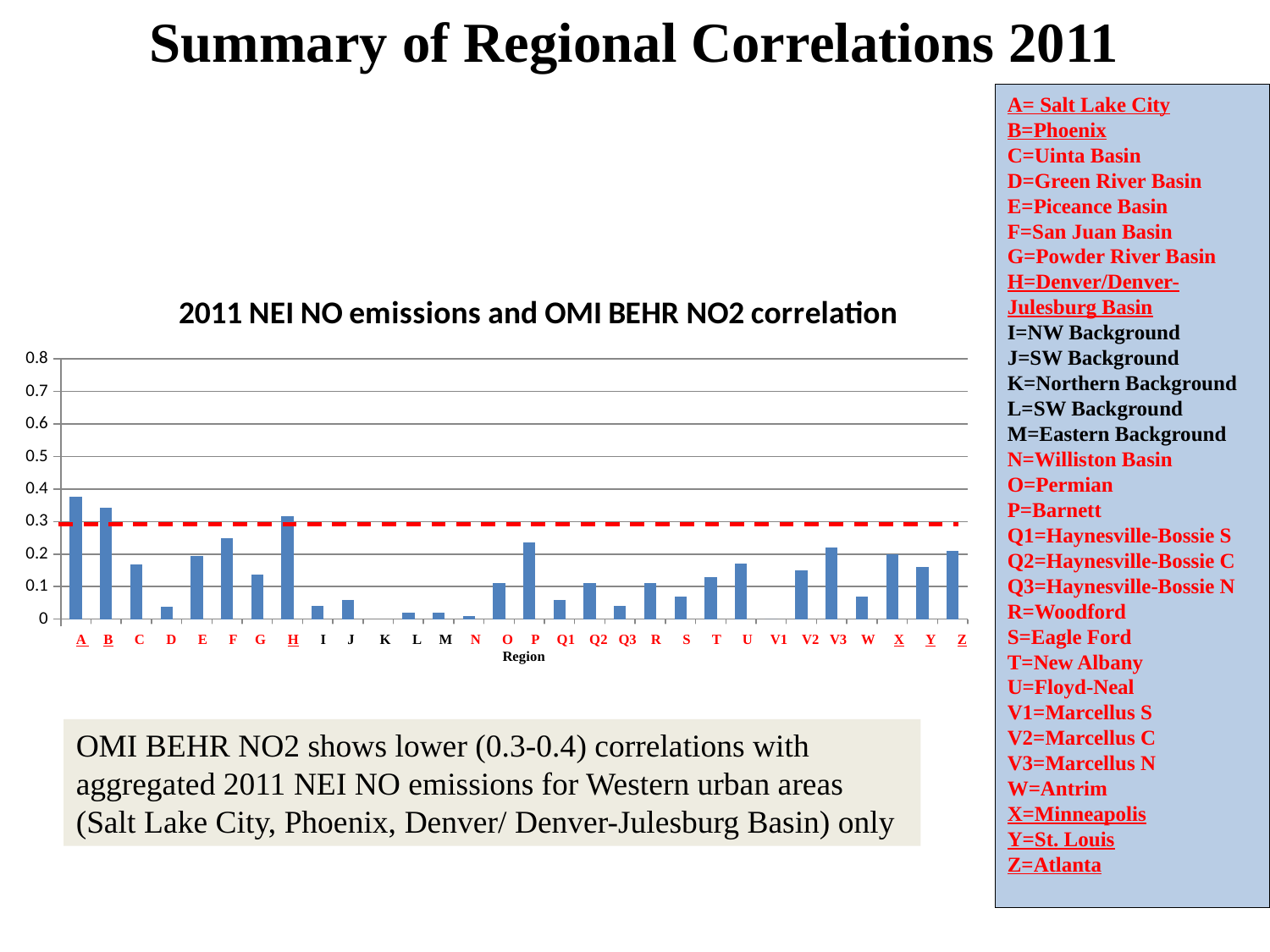
What is the label of the x axis of the chart? Region Which region has the highest correlation value? A Which is larger, the value for E or the value for D? E Which region has the lowest correlation value? K Is the value for A greater or less than 0.3? greater What kind of chart is shown on the slide? bar chart How many regions (categories) are plotted along the x axis? 30 Is the value for P greater or less than 0.3? less What is the title of the chart? 2011 NEI NO emissions and OMI BEHR NO2 correlation Is the value for F greater or less than 0.2? greater Which is larger, the value for P or the value for Q1? P